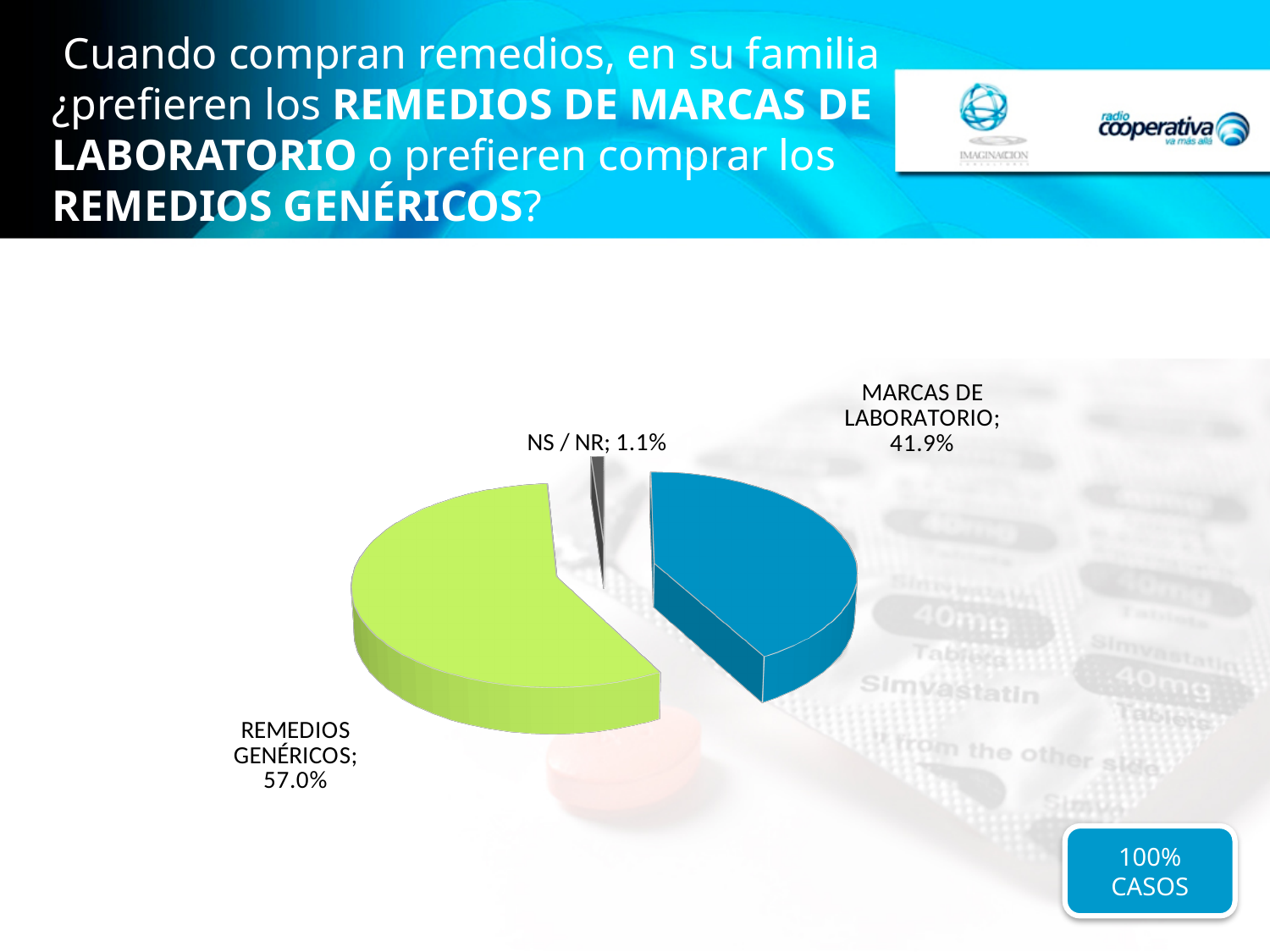
Which category has the smallest share of the pie? NS / NR How many slices does the pie chart have? 3 Which is larger, the share for MARCAS DE LABORATORIO or the share for REMEDIOS GENÉRICOS? REMEDIOS GENÉRICOS What is the difference in percentage points between MARCAS DE LABORATORIO and NS / NR? 40.8 Which category has the largest share of the pie? REMEDIOS GENÉRICOS What is the value shown for NS / NR? 1.1% What type of chart is shown on the slide? Pie chart What colour is the slice for MARCAS DE LABORATORIO? Blue What colour is the slice for REMEDIOS GENÉRICOS? Green What is the difference in percentage points between REMEDIOS GENÉRICOS and MARCAS DE LABORATORIO? 15.1 What percentage of respondents prefer MARCAS DE LABORATORIO? 41.9% What percentage of respondents prefer REMEDIOS GENÉRICOS? 57.0%